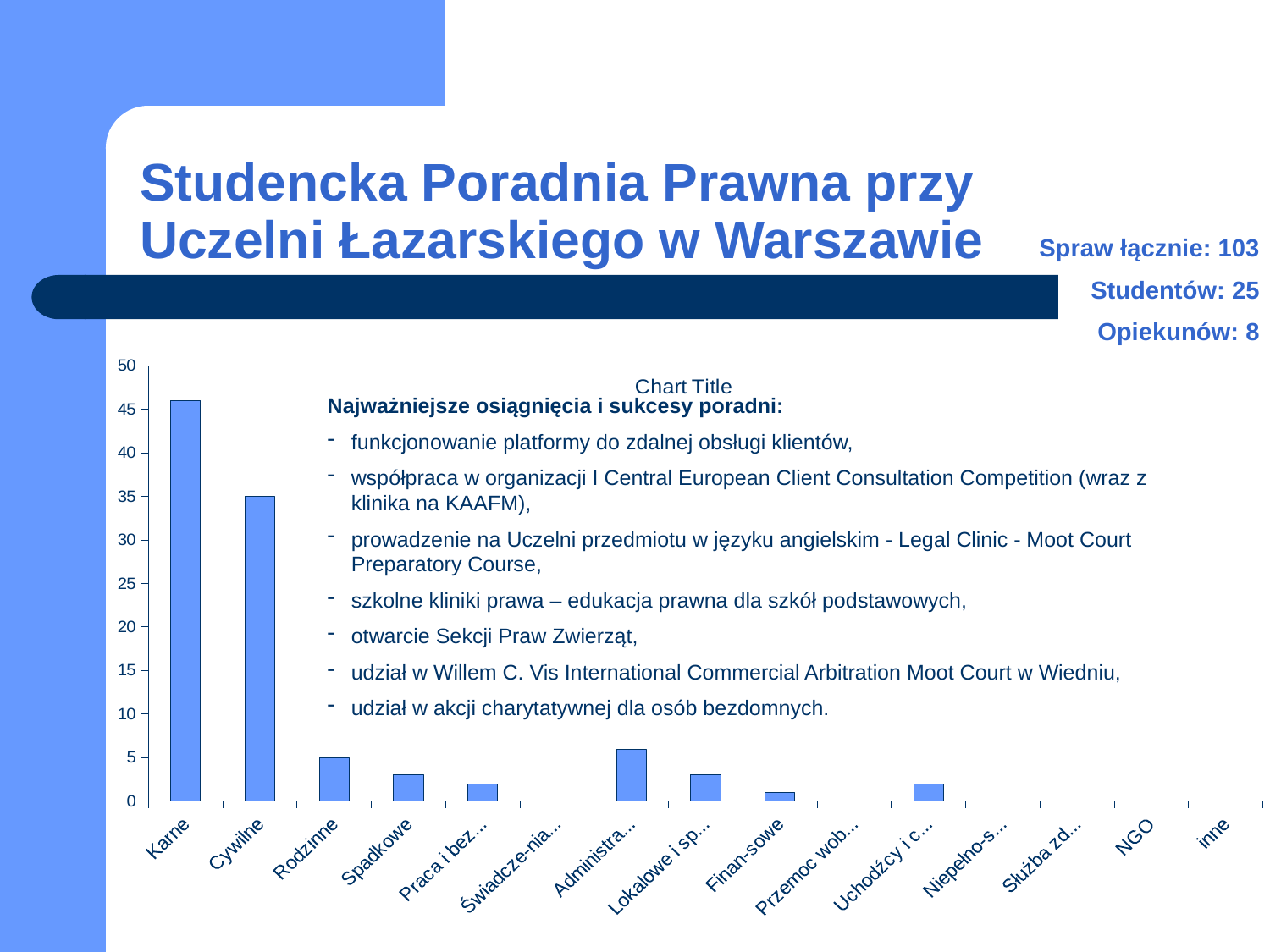
Which is larger, the value for Karne or the value for Cywilne? Karne What kind of chart is shown on the slide? bar chart Which category has the highest value in the chart? Karne Is the value for Administra... greater or less than 10? less Is the value for Karne greater or less than 40? greater Which is larger, the value for Rodzinne or the value for Spadkowe? Rodzinne How many categories are shown on the x axis of the chart? 15 What is the value for Cywilne? 35 What is the value for Rodzinne? 5 Is the value for Spadkowe greater or less than 5? less Do the values generally rise or fall from left to right along the x axis? fall What title is displayed on the chart? Chart Title